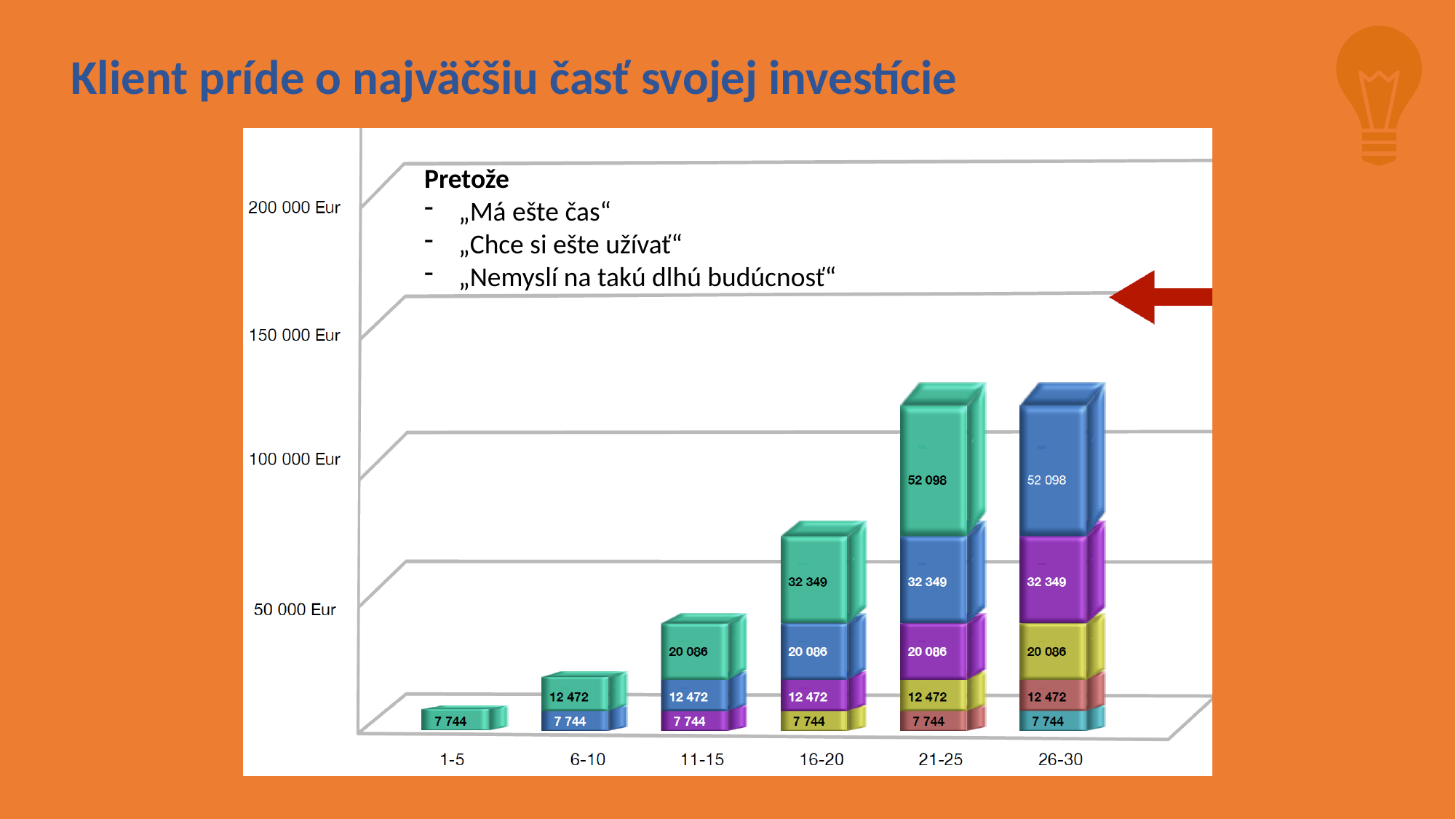
Is the total of the 21-25 bar greater or less than 100 000 Eur? greater What is the value shown for the 1-5 bar? 7 744 What kind of chart is shown on the slide? stacked bar chart Is the total of the 16-20 bar greater or less than 100 000 Eur? less How many categories are shown on the x axis of the chart? 6 What is the value of the second segment from the bottom in the 26-30 bar? 12 472 Do the bar totals rise or fall from 1-5 to 21-25 along the x axis? rise What is the value of the top segment of the 21-25 bar? 52 098 Which category has the lowest bar? 1-5 What is the total of the stacked 11-15 bar? 40 302 What is the difference between the 52 098 segment and the 32 349 segment in the 26-30 bar? 19 749 What is the total of the stacked 6-10 bar? 20 216